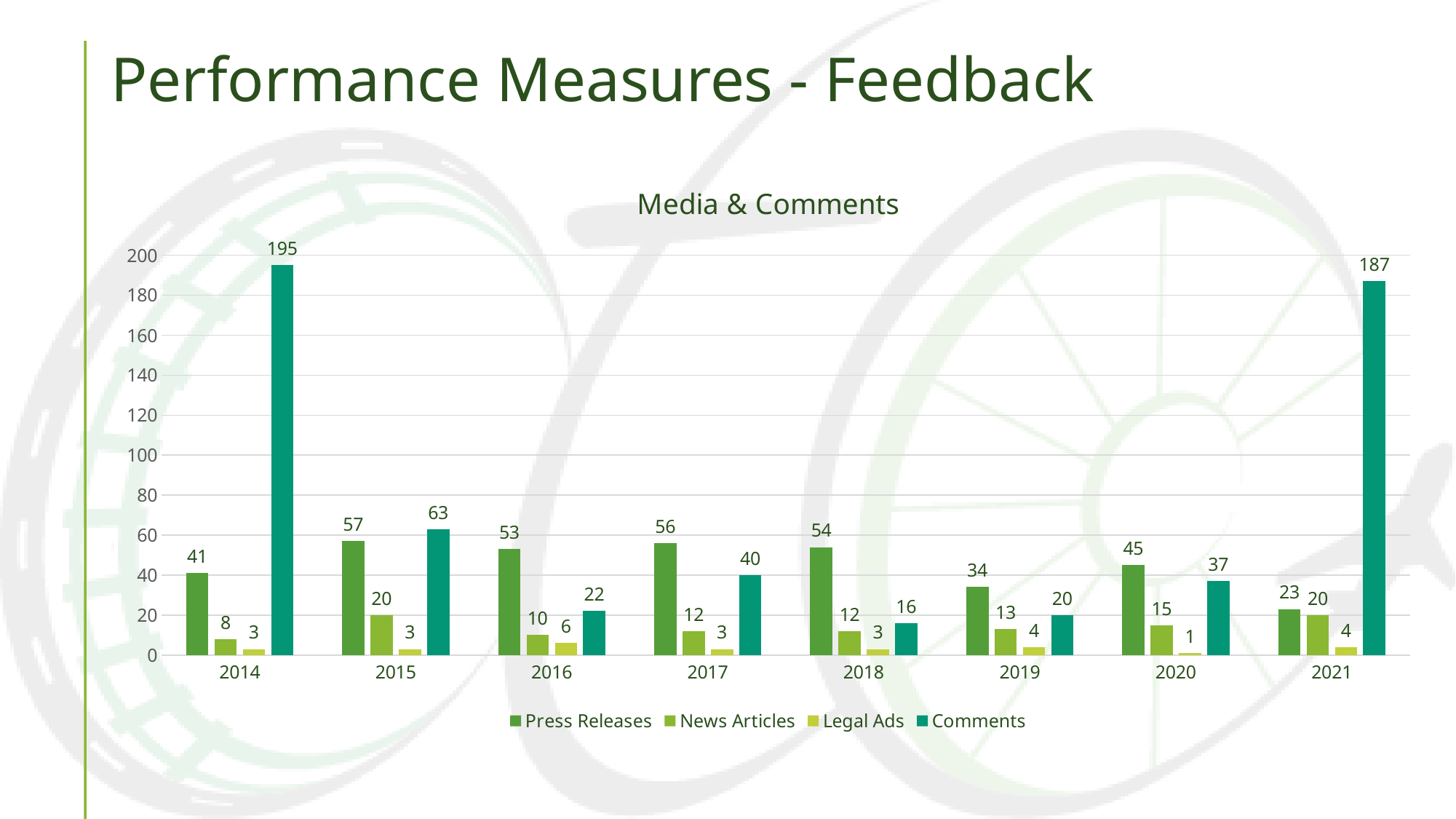
Which year has the lowest value for Comments? 2018 How many series does the legend list? 4 Which is larger, News Articles in 2015 or News Articles in 2019? News Articles in 2015 How many years are shown on the x axis? 8 What is the value for Press Releases in 2017? 56 What is the title of the chart? Media & Comments What is the value for Comments in 2014? 195 What kind of chart is shown on the slide? Bar chart Do the Press Releases values rise or fall from 2018 to 2021? Fall Which year has the highest value for Press Releases? 2015 What is the difference between Comments in 2014 and Comments in 2021? 8 What is the value for Legal Ads in 2020? 1